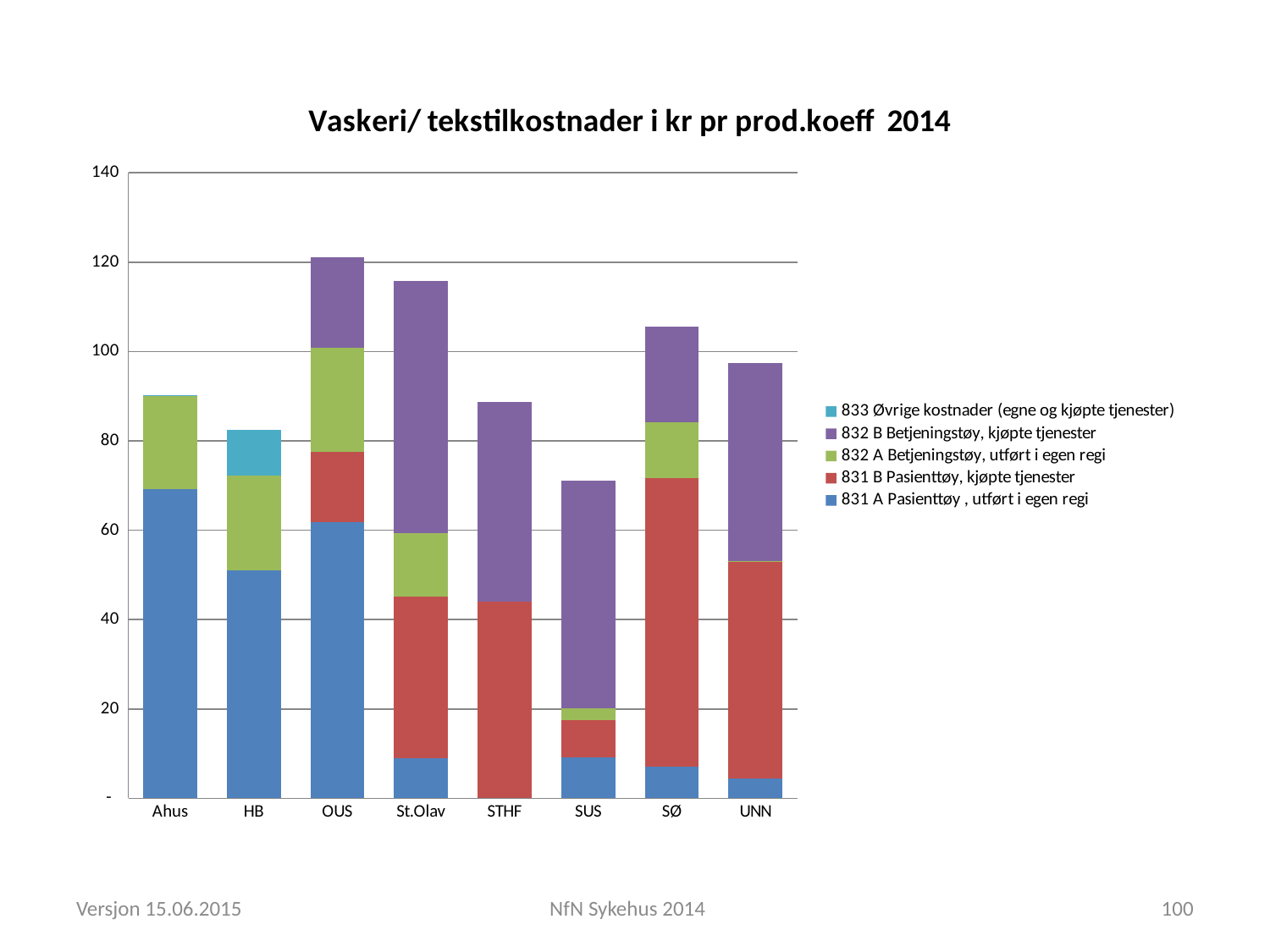
Is the total value for OUS greater or less than 100? greater Is the total value for St.Olav greater or less than 100? greater What is the title of the chart? Vaskeri/ tekstilkostnader i kr pr prod.koeff 2014 How many series does the legend list? 5 How many hospitals (categories) are shown on the x axis? 8 Is the total value for SUS greater or less than 80? less Which has the larger total bar, Ahus or HB? Ahus What kind of chart is shown on the slide? stacked bar chart Which hospital is the only one with a segment for '833 Øvrige kostnader (egne og kjøpte tjenester)'? HB Which hospital has the highest total bar? OUS Which hospital has the lowest total bar? SUS